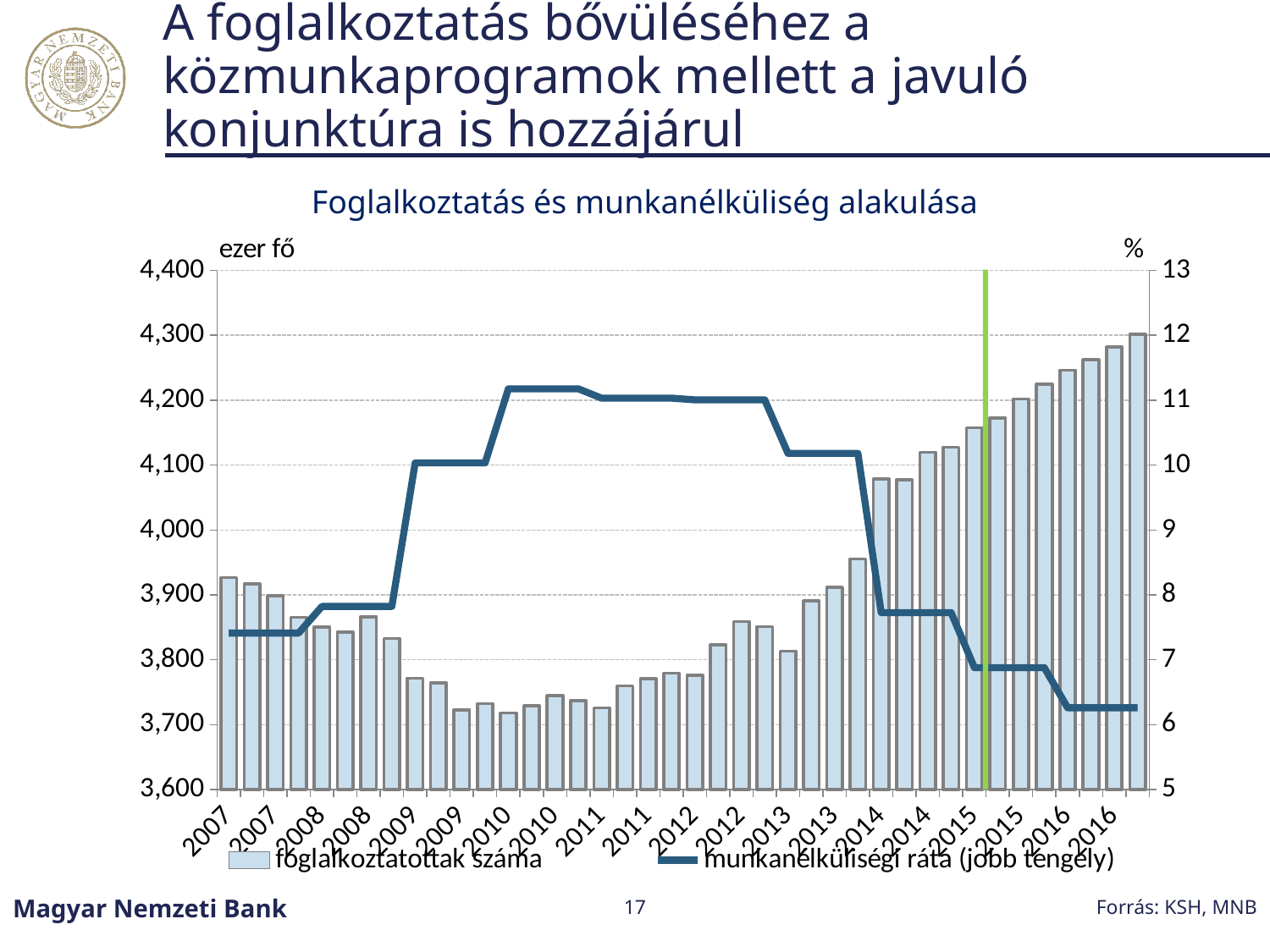
Do the foglalkoztatottak száma bars rise or fall from 2013 to 2016? rise Is the munkanélküliségi ráta in 2010 greater or less than 10? greater How many series does the legend list? 2 What kind of chart is shown on the slide? A combined bar and line chart Is the munkanélküliségi ráta at the end of 2016 greater or less than 7? less What is the title of the chart? Foglalkoztatás és munkanélküliség alakulása Is the first bar (2007) for foglalkoztatottak száma greater or less than 3,800? greater Which is larger, the foglalkoztatottak száma bar at the start of 2007 or at the end of 2016? end of 2016 Which year has the highest foglalkoztatottak száma bar? 2016 Which series is plotted on the right axis according to the legend? munkanélküliségi ráta (jobb tengely) Does the munkanélküliségi ráta line rise or fall from 2013 to 2016? fall